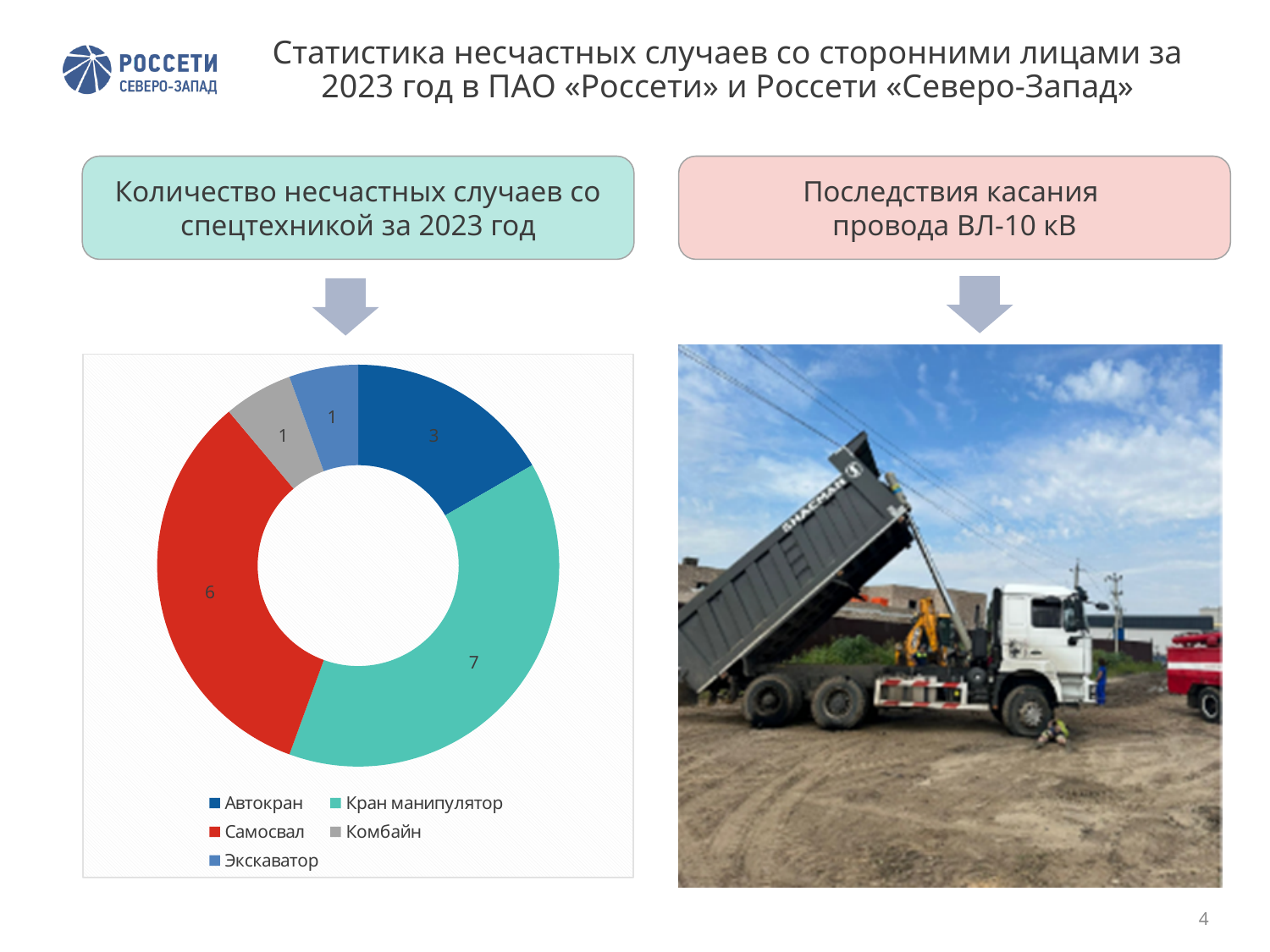
What is the difference between the values for Кран манипулятор and Самосвал? 1 What colour represents Самосвал in the chart? Red What is the value for Автокран in the chart? 3 Which categories share the lowest value in the chart? Комбайн and Экскаватор Which is larger, the value for Самосвал or the value for Автокран? Самосвал What type of chart is shown on the slide? Doughnut (pie) chart What is the total number of accidents across all categories in the chart? 18 How many categories does the chart's legend list? 5 What is the value for Комбайн in the chart? 1 How many accidents are shown for Кран манипулятор in the doughnut chart? 7 What is the value for Самосвал in the chart? 6 Which category has the highest number of accidents in the chart? Кран манипулятор